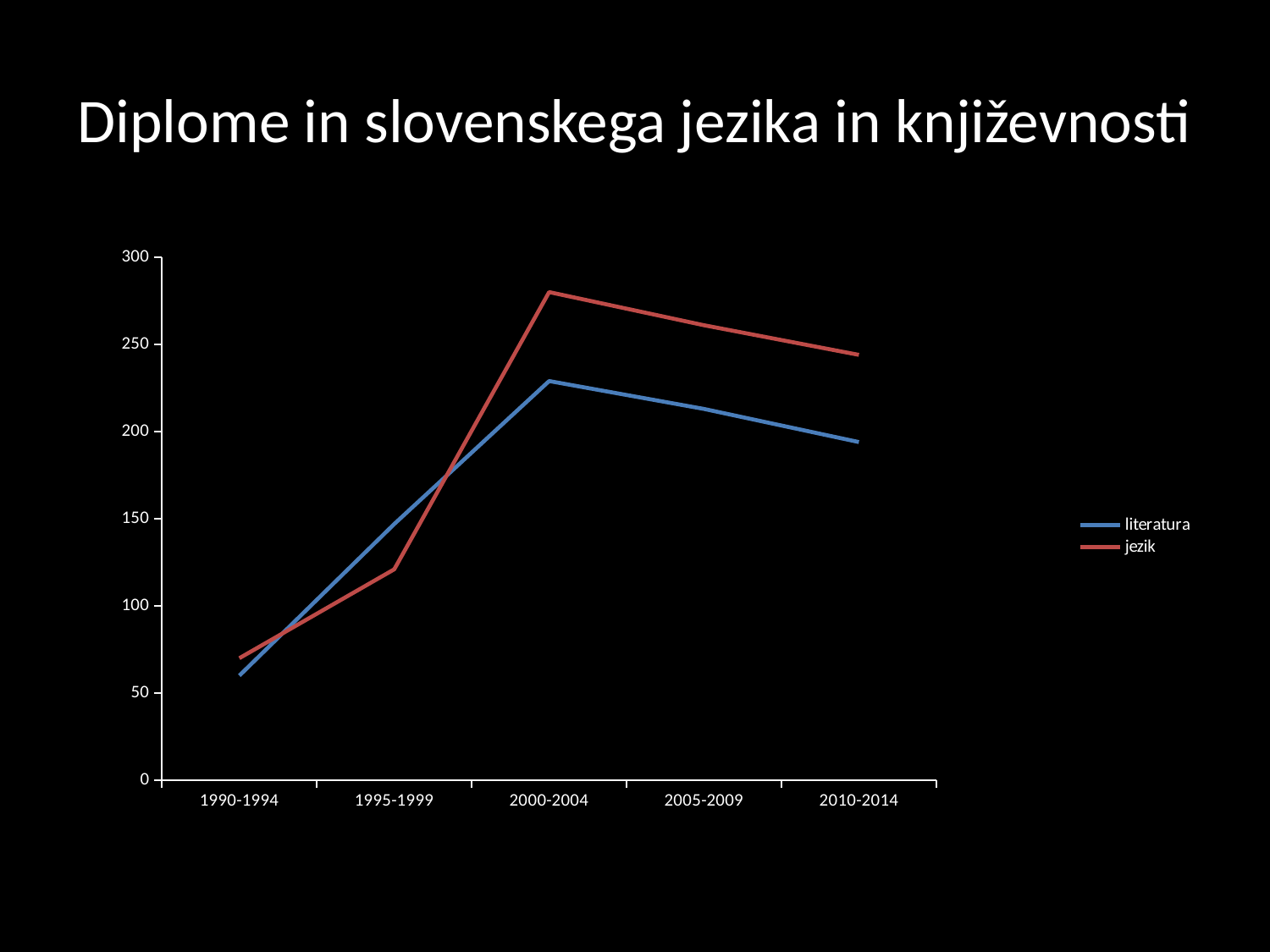
Is the value for literatura in 1990-1994 greater or less than 100? less In which period does the literatura series have its lowest value? 1990-1994 Does the jezik series rise or fall from 2000-2004 to 2010-2014? fall How many series does the legend list? 2 Is the value for jezik in 2000-2004 greater or less than 250? greater In 2000-2004, which series has the larger value, literatura or jezik? jezik What kind of chart is shown on the slide? line chart Is the value for jezik in 1995-1999 greater or less than 150? less What is the title of the chart? Diplome in slovenskega jezika in književnosti How many periods are labelled on the x axis? 5 In which period does the jezik series reach its highest value? 2000-2004 Which colour is used for the jezik series? red